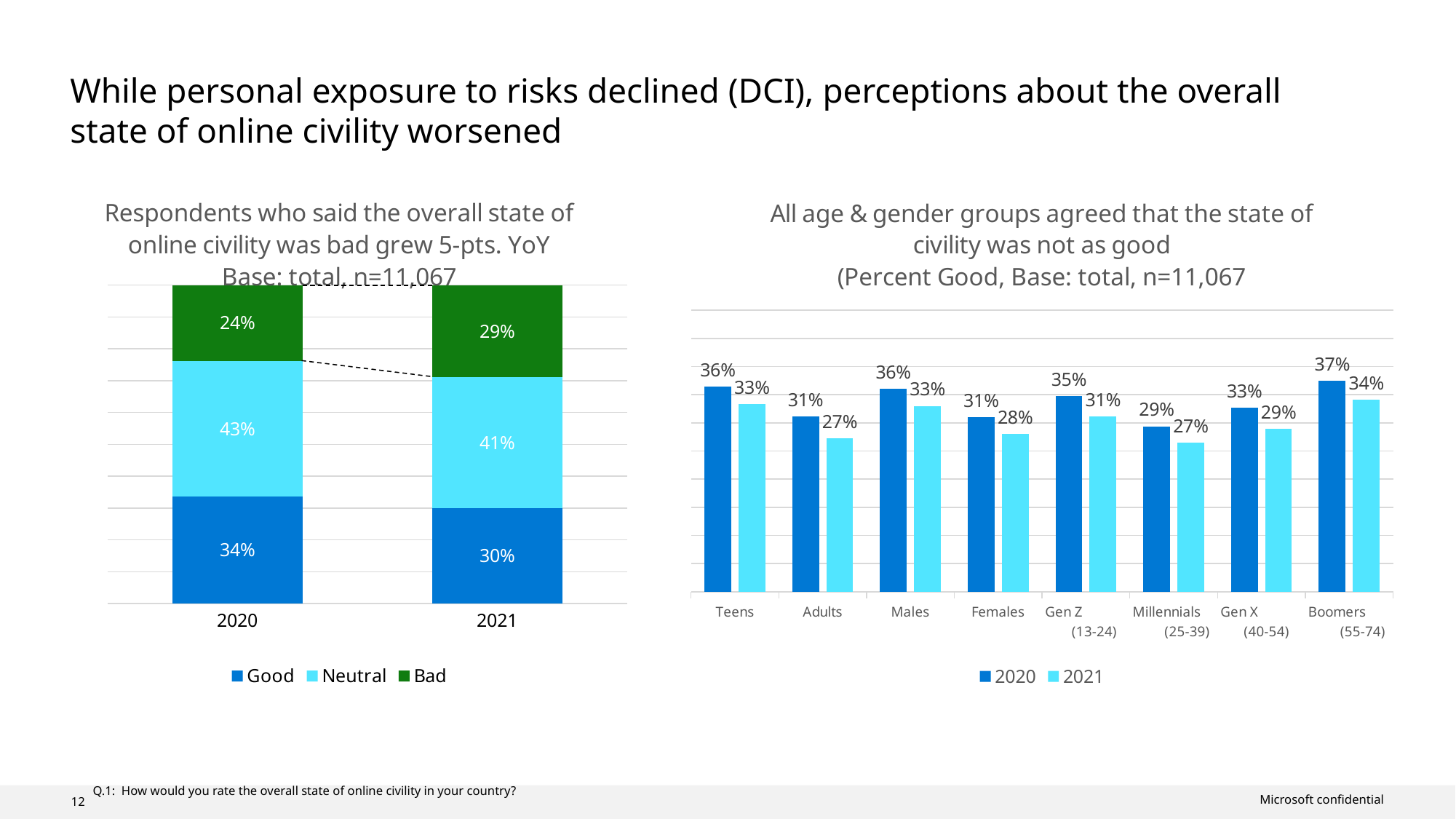
In the left chart, how many series does the legend list? 3 In the right chart, which group had the highest Percent Good in 2020? Boomers In the left chart, what is the total of the three segments for the 2020 bar? 101% In the right chart, which group had the lowest Percent Good in 2021? Adults and Millennials (tied at 27%) What kind of chart is the left chart? Stacked bar chart In the right chart, what is the difference between the 2020 and 2021 Percent Good values for Gen Z? 4% In the left chart, what percentage of respondents rated the state of online civility as Bad in 2021? 29% In the right chart, which is larger: the 2021 value for Teens or the 2021 value for Adults? Teens In the left chart, what percentage of respondents rated the state of online civility as Neutral in 2020? 43% In the left chart, by how many percentage points did the Good share fall from 2020 to 2021? 4 percentage points In the right chart, how many groups are shown on the x axis? 8 In the right chart, what was the Percent Good for Boomers in 2020? 37%